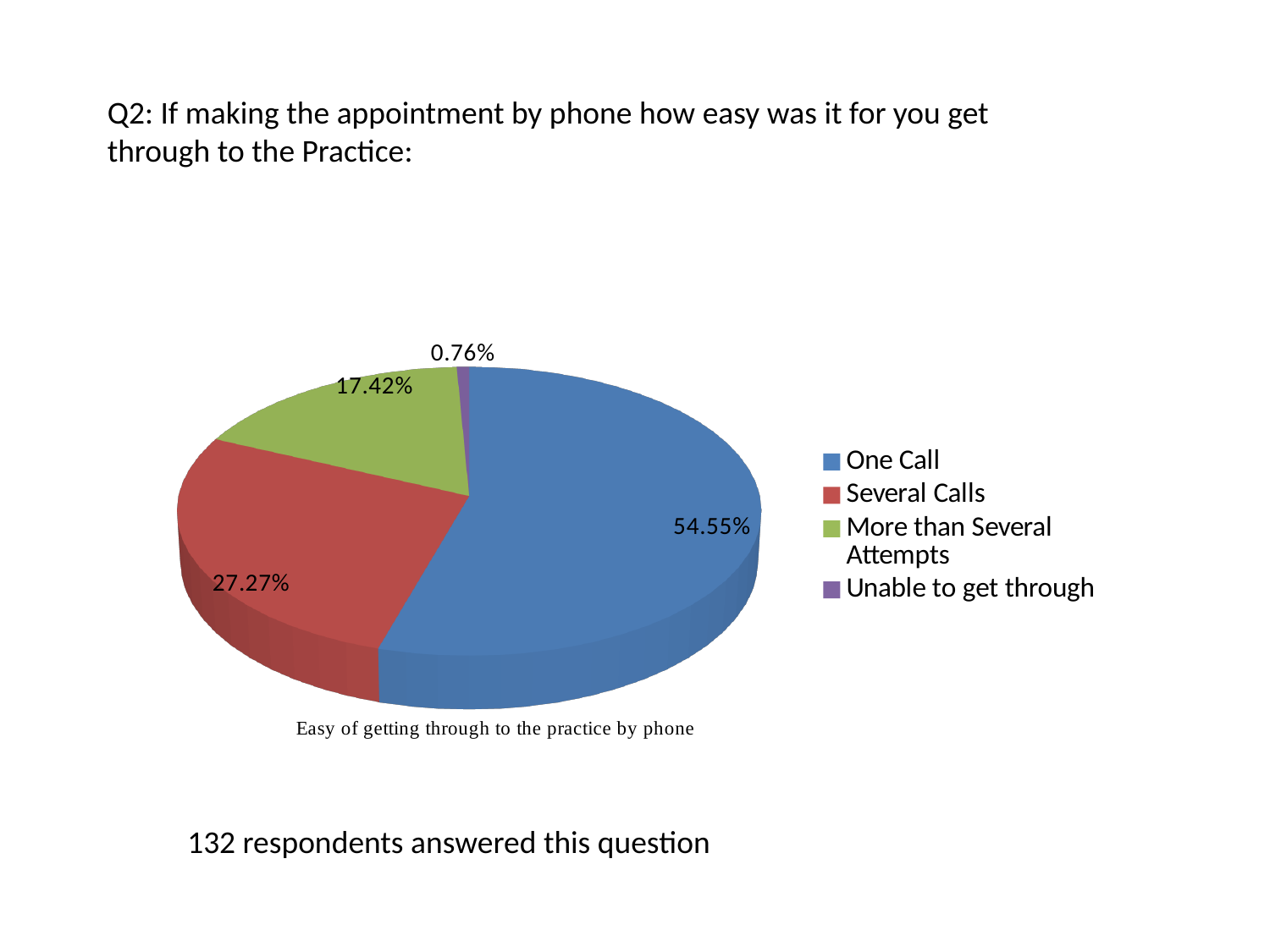
Which is larger, the share for Several Calls or the share for More than Several Attempts? Several Calls Which category has the largest share of the pie? One Call How many categories does the legend list? 4 Which category has the smallest share of the pie? Unable to get through What is the title shown below the pie chart? Easy of getting through to the practice by phone What percentage of respondents needed more than several attempts? 17.42% What percentage of respondents needed several calls? 27.27% What colour is the slice for One Call? blue What percentage of respondents were unable to get through? 0.76% What percentage of respondents got through in one call? 54.55% What is the difference in percentage points between One Call and Several Calls? 27.28 What kind of chart is shown on the slide? pie chart